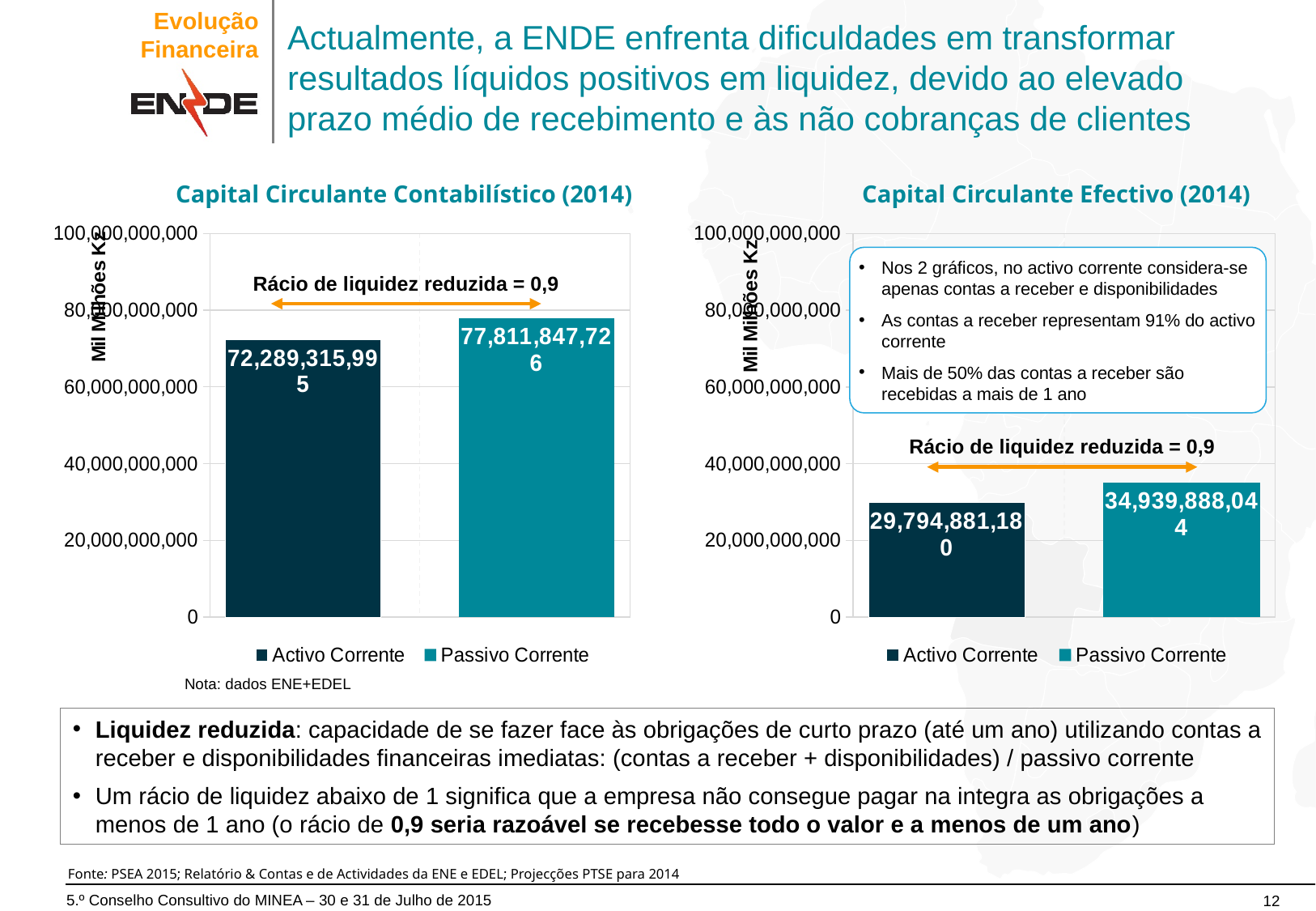
In the 'Capital Circulante Efectivo (2014)' chart, which bar is the lowest? Activo Corrente In the 'Capital Circulante Efectivo (2014)' chart, what is the difference between Passivo Corrente and Activo Corrente? 5,145,006,864 In the 'Capital Circulante Contabilístico (2014)' chart, which is larger, Activo Corrente or Passivo Corrente? Passivo Corrente What type of chart is 'Capital Circulante Contabilístico (2014)'? Bar chart In the 'Capital Circulante Contabilístico (2014)' chart, what is the difference between Passivo Corrente and Activo Corrente? 5,522,531,731 In the 'Capital Circulante Efectivo (2014)' chart, is the value for Activo Corrente greater or less than 40,000,000,000? less In the 'Capital Circulante Contabilístico (2014)' chart, is the value for Passivo Corrente greater or less than 60,000,000,000? greater How many series does the legend of the 'Capital Circulante Efectivo (2014)' chart list? 2 In the 'Capital Circulante Contabilístico (2014)' chart, what is the value for Activo Corrente? 72,289,315,995 In the 'Capital Circulante Efectivo (2014)' chart, what is the value for Activo Corrente? 29,794,881,180 In the 'Capital Circulante Contabilístico (2014)' chart, what is the value for Passivo Corrente? 77,811,847,726 In the 'Capital Circulante Efectivo (2014)' chart, what is the value for Passivo Corrente? 34,939,888,044